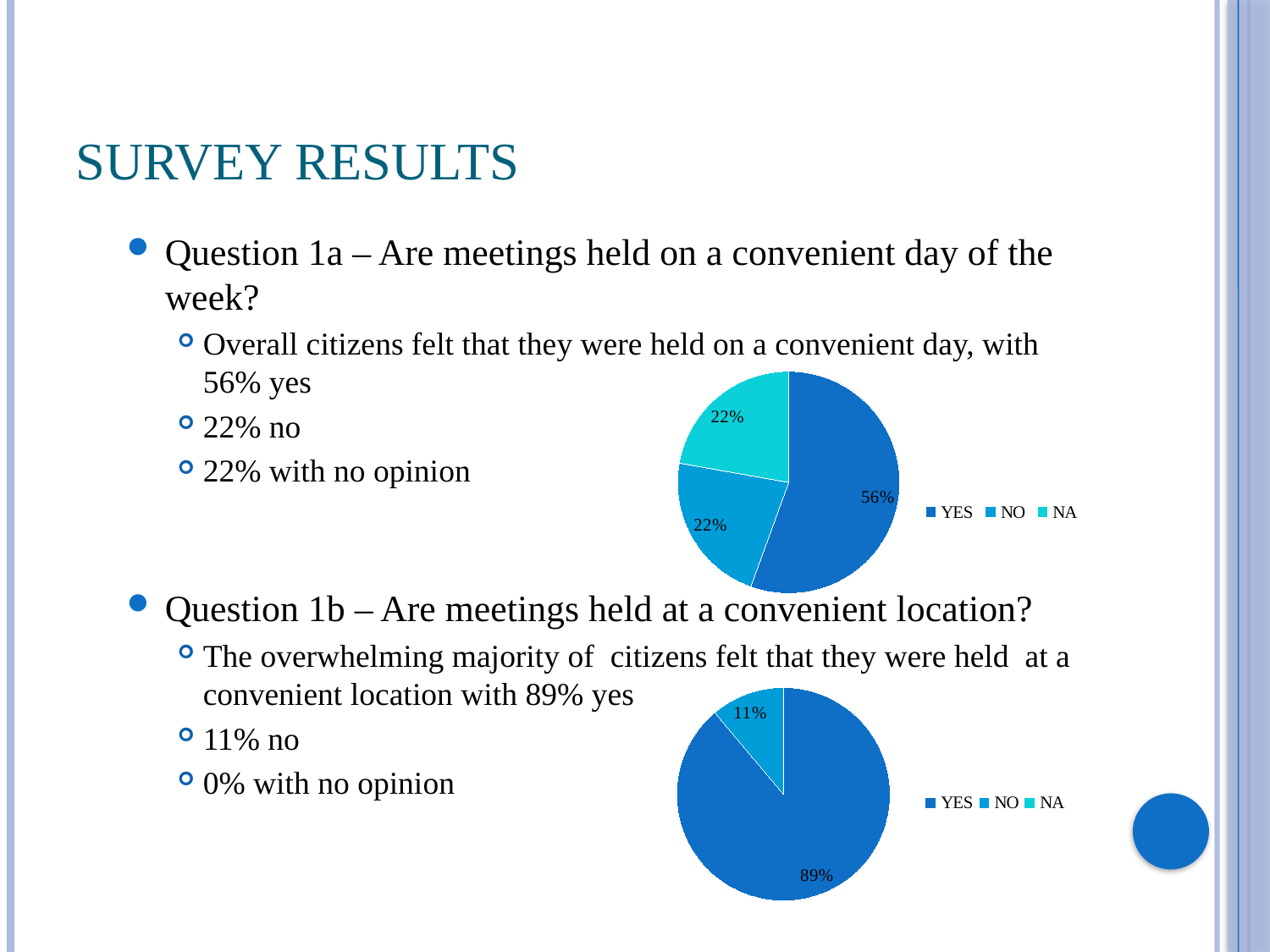
How many entries does the legend of the upper pie chart list? 3 In the upper pie chart, what percentage of the pie is the YES slice? 56% In the lower pie chart, which category has the largest slice? YES Which chart shows a larger YES share, the upper pie chart or the lower pie chart? The lower pie chart What kind of chart is the upper chart on the slide? Pie chart In the upper pie chart, which category has the largest slice? YES In the lower pie chart, what is the difference in percentage points between the YES and NO slices? 78 percentage points In the lower pie chart, what percentage is shown for the YES slice? 89% What are the legend entries of the lower pie chart? YES, NO, NA In the lower pie chart, what share of the pie is the NO slice? 11% In the upper pie chart, what percentage is shown for the NO slice? 22% In the upper pie chart, by how many percentage points does the YES slice exceed the NO slice? 34 percentage points